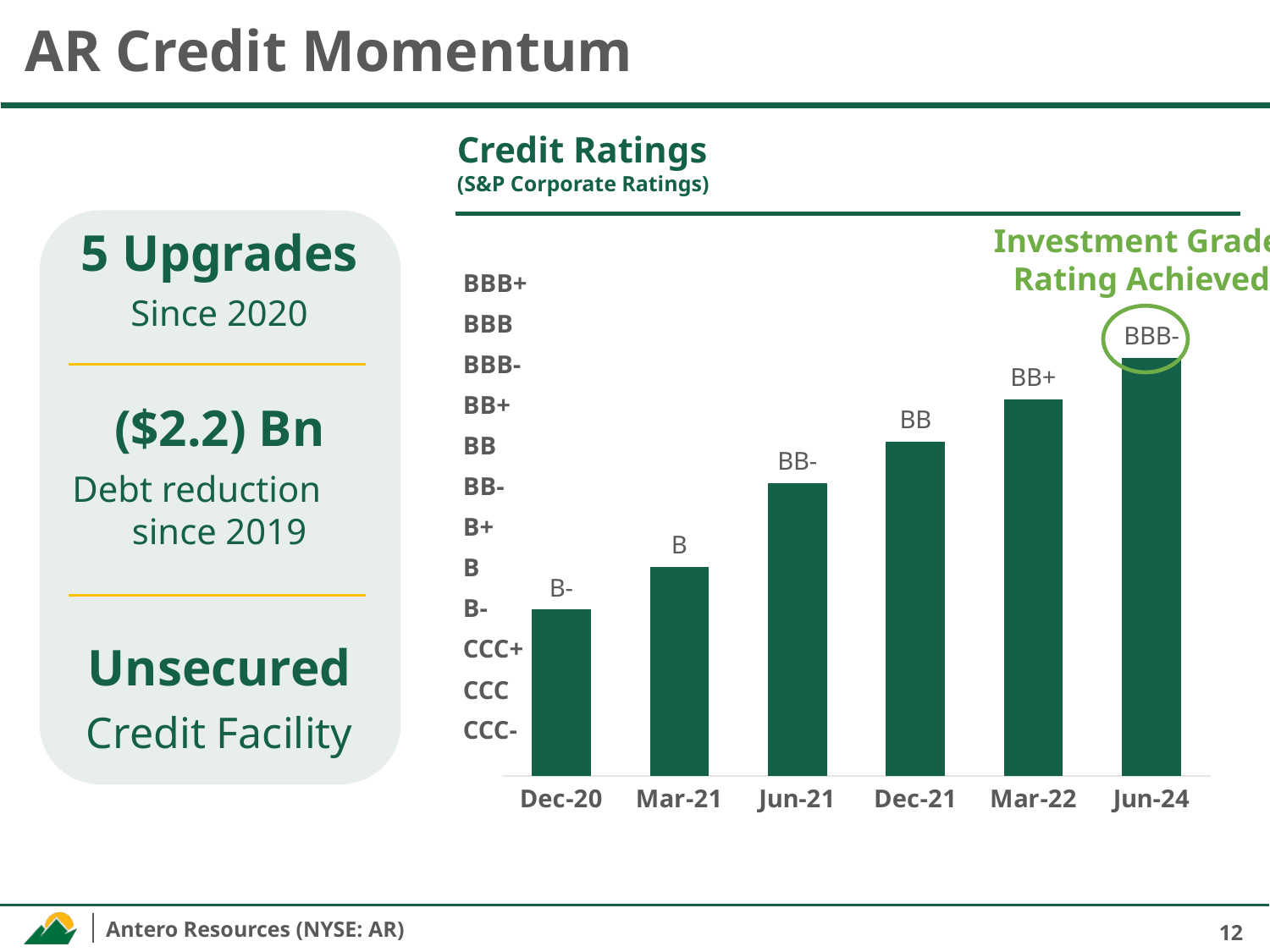
Which has the higher credit rating, Jun-21 or Mar-22? Mar-22 How many dates are shown on the x axis of the chart? 6 What is the credit rating shown for Mar-22? BB+ What kind of chart is used to show the credit ratings? Bar chart What is the credit rating shown for Jun-21? BB- What is the credit rating shown for Jun-24? BBB- Do the credit ratings rise or fall from Dec-20 to Jun-24? Rise Which date has the lowest credit rating on the chart? Dec-20 What is the credit rating shown for Dec-20? B- What is the credit rating shown for Dec-21? BB Which date has the highest credit rating on the chart? Jun-24 What is the credit rating shown for Mar-21? B